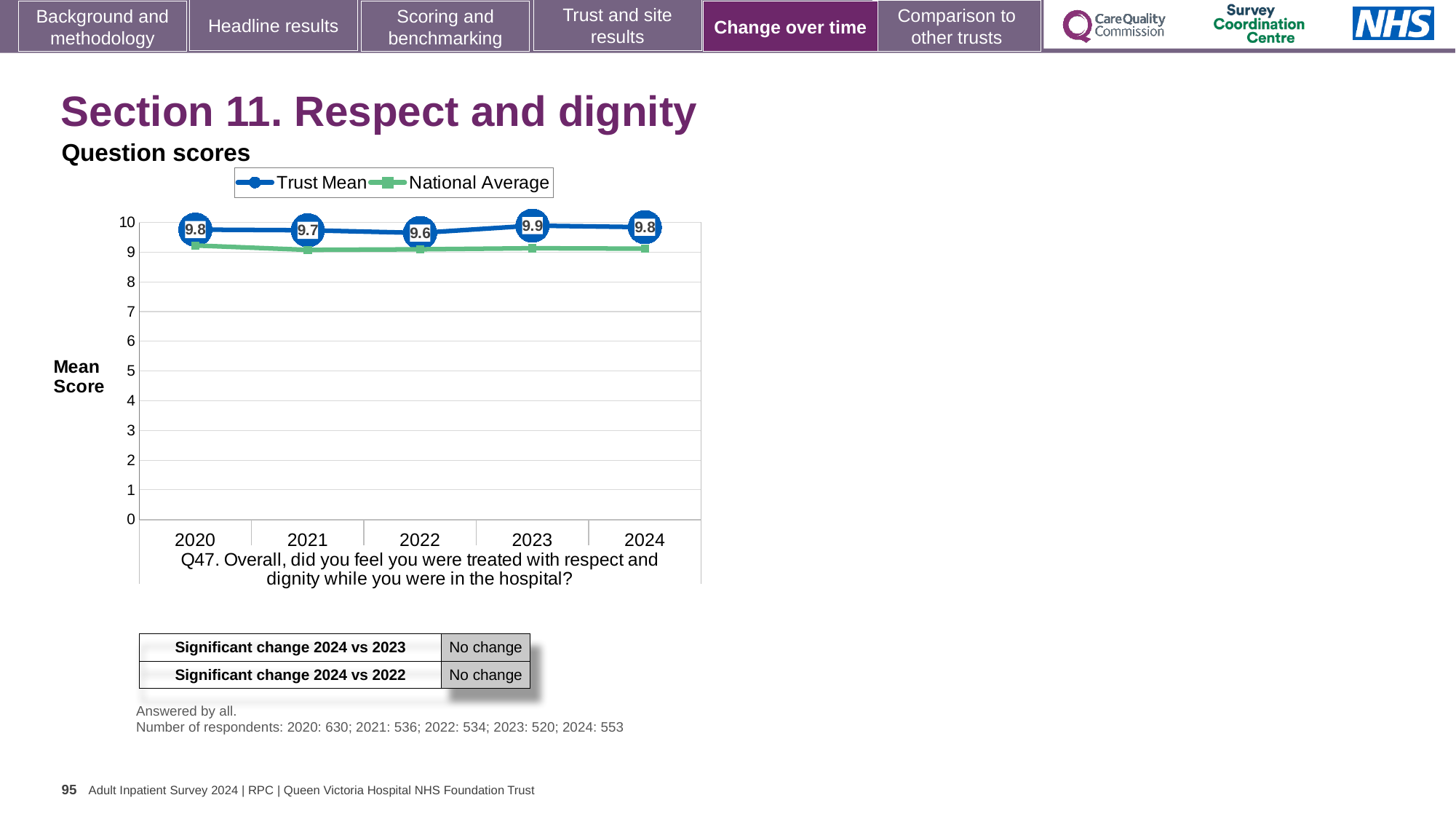
What is the Trust Mean score for 2023? 9.9 Which is larger, the Trust Mean score for 2021 or for 2023? 2023 Does the Trust Mean score rise or fall from 2022 to 2023? Rise In which year is the Trust Mean score lowest? 2022 What is the difference between the Trust Mean scores for 2023 and 2022? 0.3 How many series does the legend list? 2 What is the Trust Mean score for 2020? 9.8 How many years are plotted on the x axis? 5 Is the National Average value for 2021 greater or less than 8? greater What is the Trust Mean score for 2022? 9.6 In which year is the Trust Mean score highest? 2023 What kind of chart is shown? Line chart